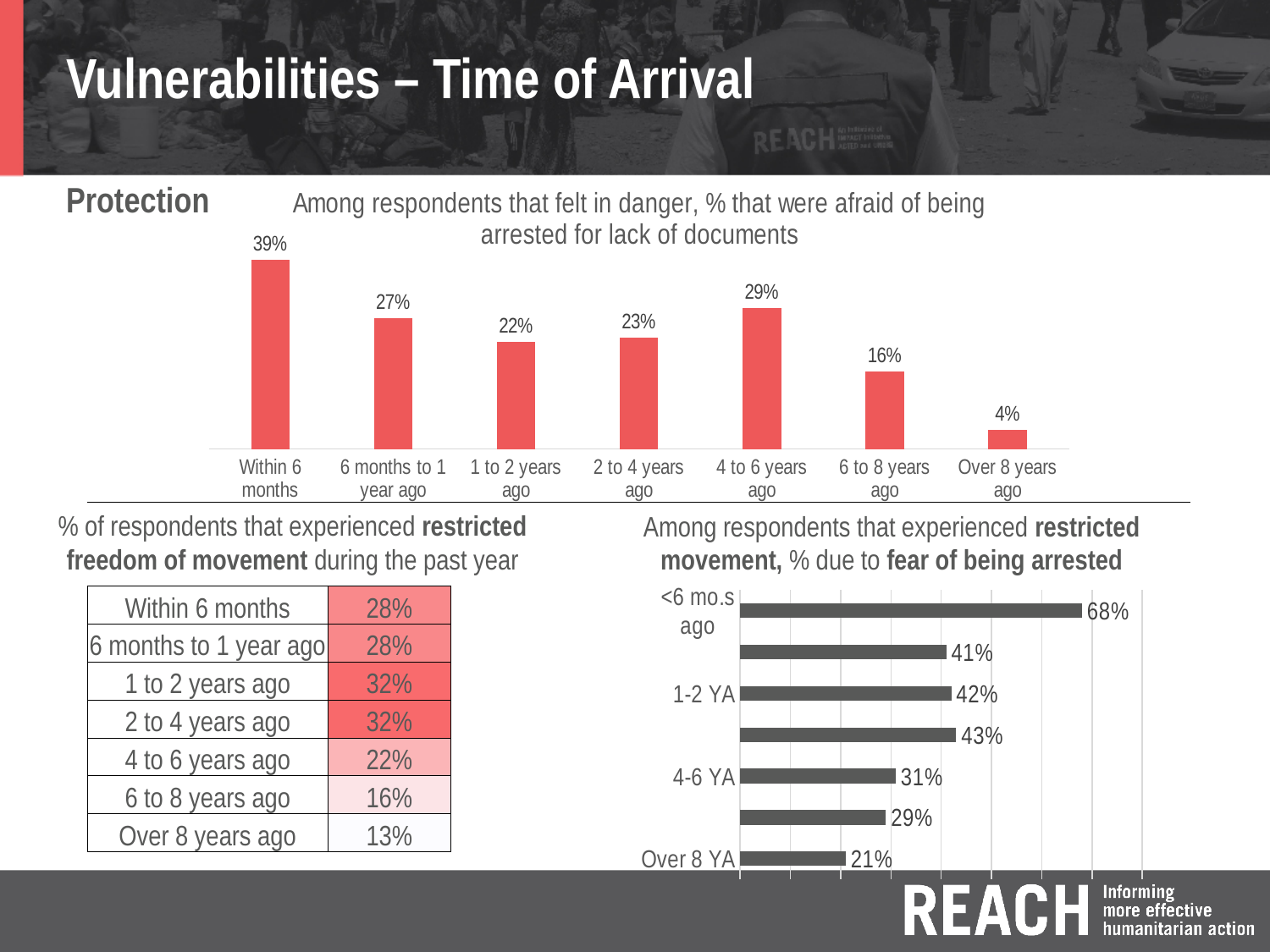
In the top chart about fear of being arrested for lack of documents, which is larger: '6 to 8 years ago' or '2 to 4 years ago'? 2 to 4 years ago What type of chart is the top chart about fear of being arrested for lack of documents? Bar chart In the bottom-right chart about restricted movement due to fear of being arrested, what is the value for '<6 mo.s ago'? 68% In the bottom-right chart about restricted movement due to fear of being arrested, what is the difference between '1-2 YA' and '4-6 YA'? 11% How many categories are shown in the top chart about fear of being arrested for lack of documents? 7 In the top chart about fear of being arrested for lack of documents, which category has the lowest value? Over 8 years ago In the top chart about fear of being arrested for lack of documents, what is the difference between 'Within 6 months' and '6 months to 1 year ago'? 12% In the top chart about fear of being arrested for lack of documents, which category has the highest value? Within 6 months In the top chart about fear of being arrested for lack of documents, what is the value for '4 to 6 years ago'? 29% In the bottom-right chart about restricted movement due to fear of being arrested, what is the value for 'Over 8 YA'? 21% How many bars are shown in the bottom-right chart about restricted movement due to fear of being arrested? 7 In the top chart about fear of being arrested for lack of documents, what is the value for 'Within 6 months'? 39%